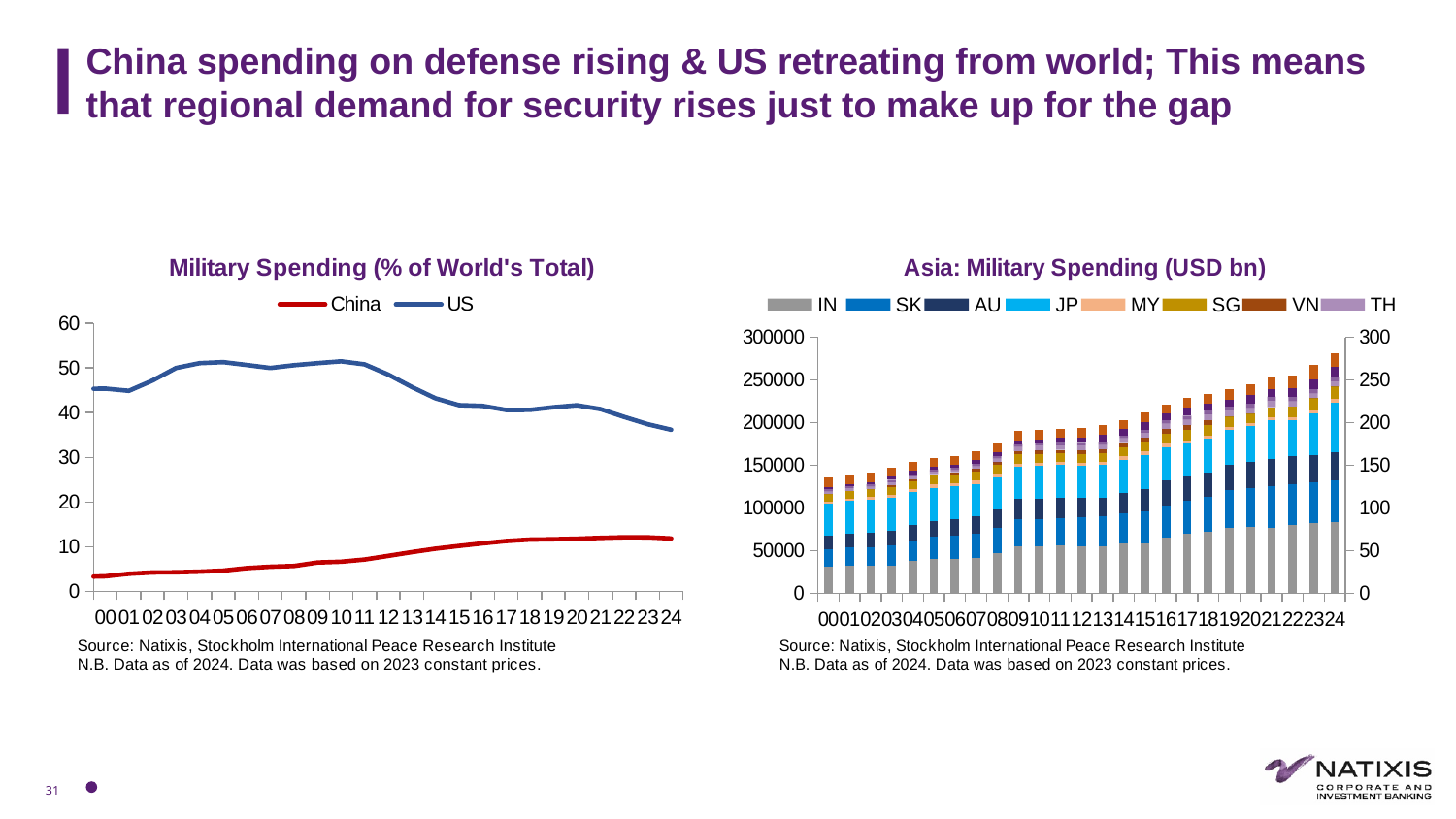
In the 'Military Spending (% of World's Total)' chart, which series is higher in 24, China or US? US What kind of chart is the 'Military Spending (% of World's Total)' chart on the left? line chart In the 'Asia: Military Spending (USD bn)' chart, is the total stacked bar for 00 greater or less than 150 on the right-hand axis? less How many series does the legend of the 'Military Spending (% of World's Total)' chart list? 2 What kind of chart is the 'Asia: Military Spending (USD bn)' chart on the right? stacked bar chart How many series does the legend of the 'Asia: Military Spending (USD bn)' chart list? 8 In the 'Asia: Military Spending (USD bn)' chart, is the total stacked bar for 24 greater or less than 250 on the right-hand axis? greater In the 'Military Spending (% of World's Total)' chart, is the China value for 00 greater or less than 10? less In the 'Asia: Military Spending (USD bn)' chart, which series is shown in grey at the bottom of each bar? IN In the 'Military Spending (% of World's Total)' chart, does the China line rise or fall from 00 to 24? rise